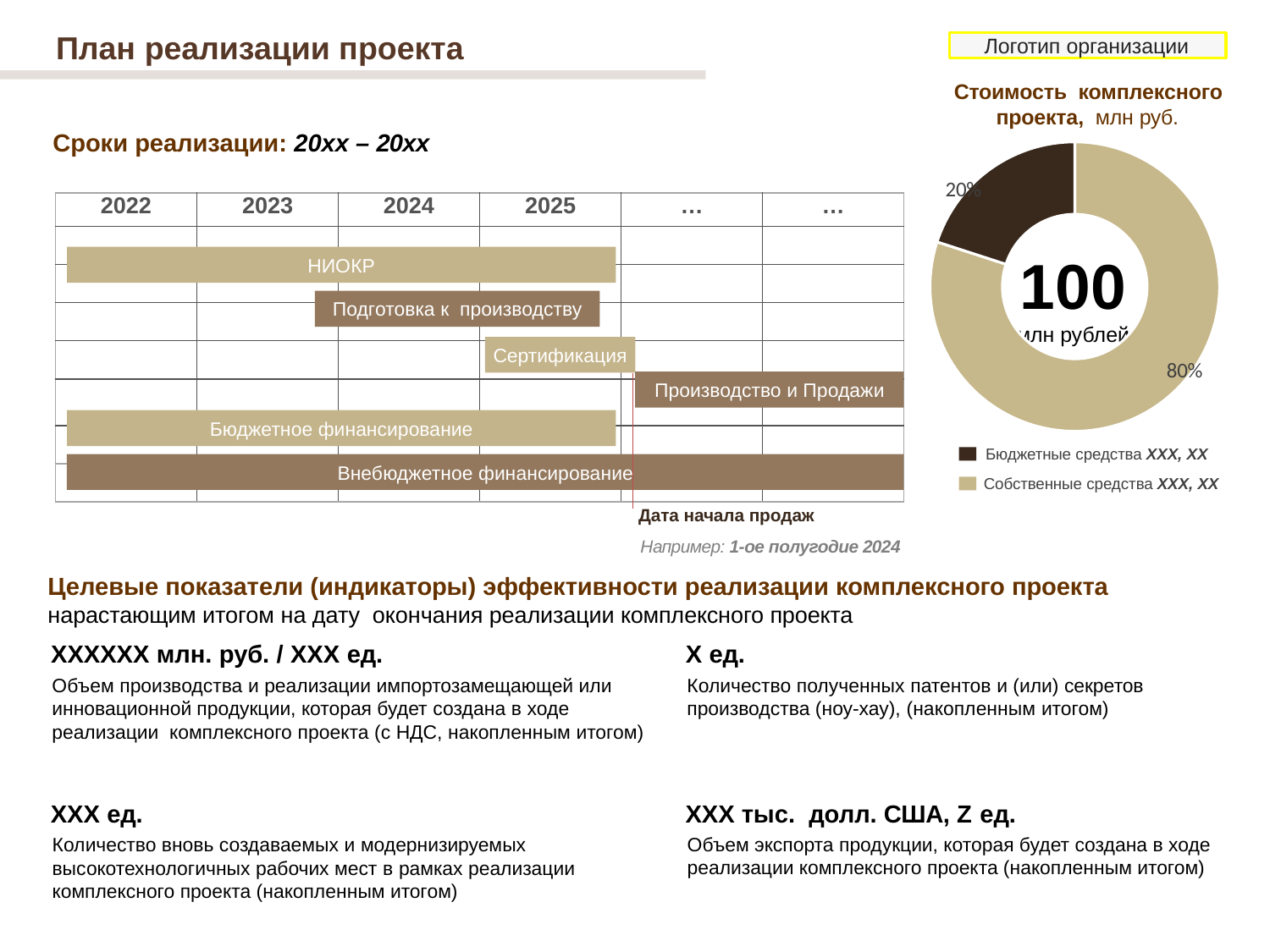
What total value is printed in the centre of the 'Стоимость комплексного проекта' chart? 100 млн рублей What kind of chart is the 'Стоимость комплексного проекта' chart? pie chart (donut) In the 'Стоимость комплексного проекта' chart, which is larger: 'Бюджетные средства' or 'Собственные средства'? Собственные средства In the 'Стоимость комплексного проекта' chart, which category has the smallest slice? Бюджетные средства In the 'Стоимость комплексного проекта' chart, which legend entry is shown in the dark brown colour? Бюджетные средства How many slices does the 'Стоимость комплексного проекта' chart have? 2 In the 'Стоимость комплексного проекта' chart, what share of the total is 'Бюджетные средства'? 20% How many entries does the legend of the 'Стоимость комплексного проекта' chart list? 2 In the 'Стоимость комплексного проекта' chart, by how many percentage points does the 'Собственные средства' share exceed the 'Бюджетные средства' share? 60 percentage points In the 'Стоимость комплексного проекта' chart, what share of the total is 'Собственные средства'? 80% What unit is stated in the title of the donut chart on the slide? млн руб. In the 'Стоимость комплексного проекта' chart, which category has the largest slice? Собственные средства